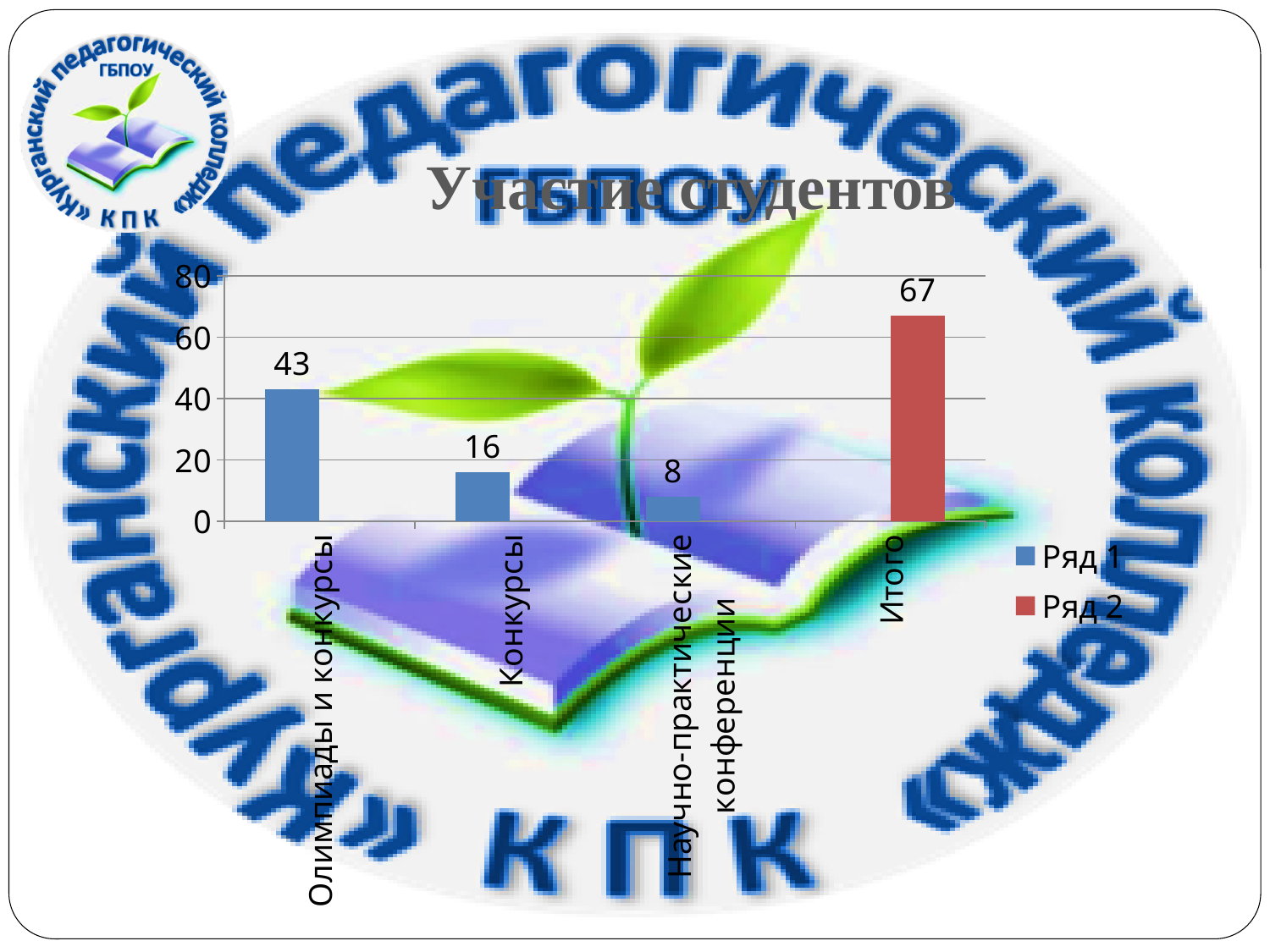
What is the value for Конкурсы? 16 How many series does the legend list? 2 Is the value for Итого greater or less than 60? greater What is the value for Итого? 67 What is the value for Олимпиады и конкурсы? 43 Which is larger, the value for Конкурсы or the value for Научно-практические конференции? Конкурсы Which category has the lowest value? Научно-практические конференции What is the value for Научно-практические конференции? 8 What is the difference between the values for Олимпиады и конкурсы and Конкурсы? 27 Which category has the highest value? Итого How many categories are shown on the x axis? 4 What kind of chart is shown on the slide? bar chart